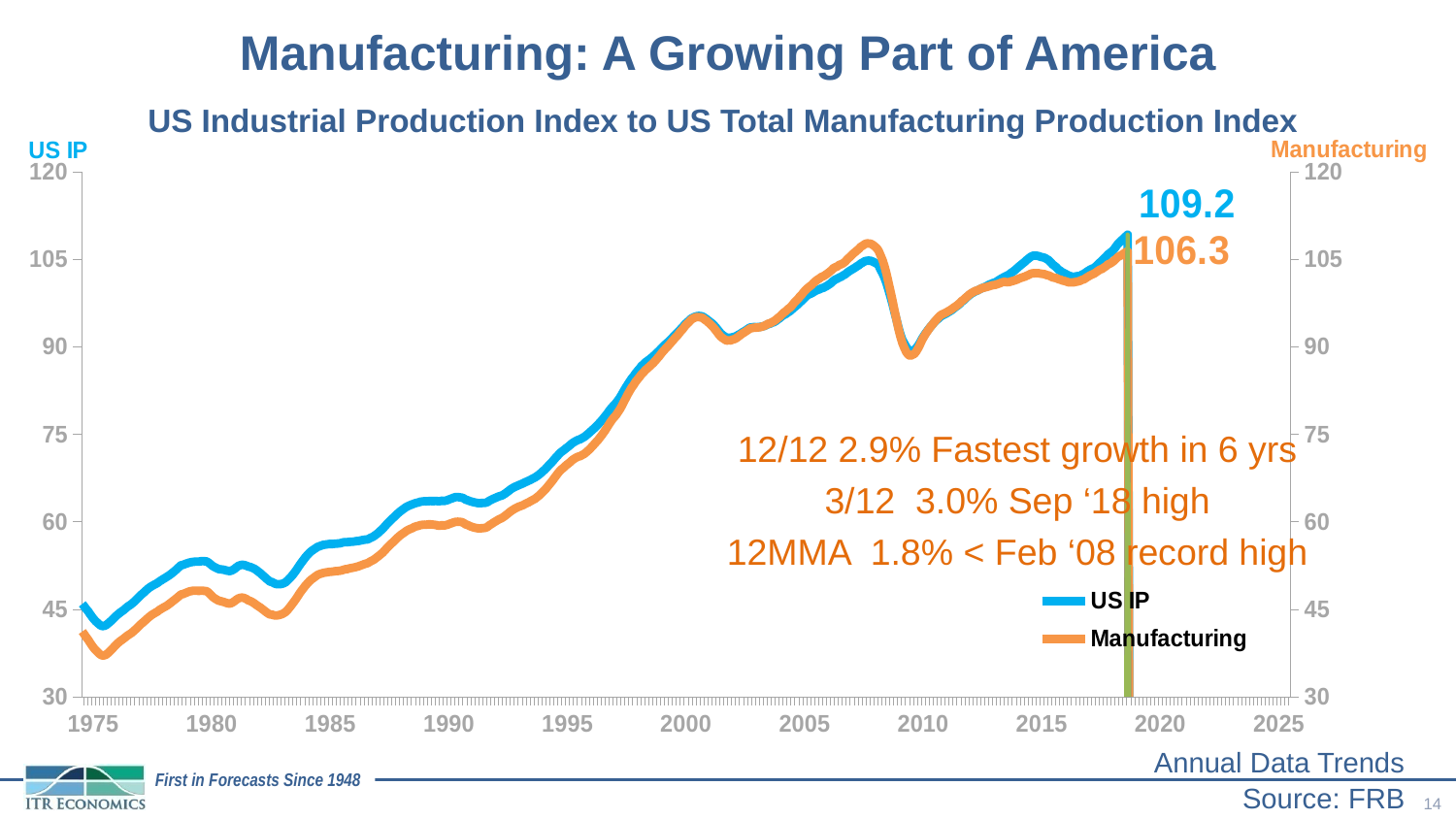
What kind of chart is shown on the slide? Line chart What is the title of the chart? US Industrial Production Index to US Total Manufacturing Production Index What is the latest labeled value of the US IP series? 109.2 Is the Manufacturing value in 1975 greater or less than 45? less What colour is the US IP line? Blue Is the US IP value in 1975 greater or less than 60? less How many series does the legend list? 2 At the latest labeled point, which series is higher, US IP or Manufacturing? US IP Overall, do the series rise or fall from 1975 to the end of the plotted data? Rise What is the latest labeled value of the Manufacturing series? 106.3 What is the difference between the latest labeled US IP value and the latest labeled Manufacturing value? 2.9 Is the US IP value in 2000 greater or less than 90? greater